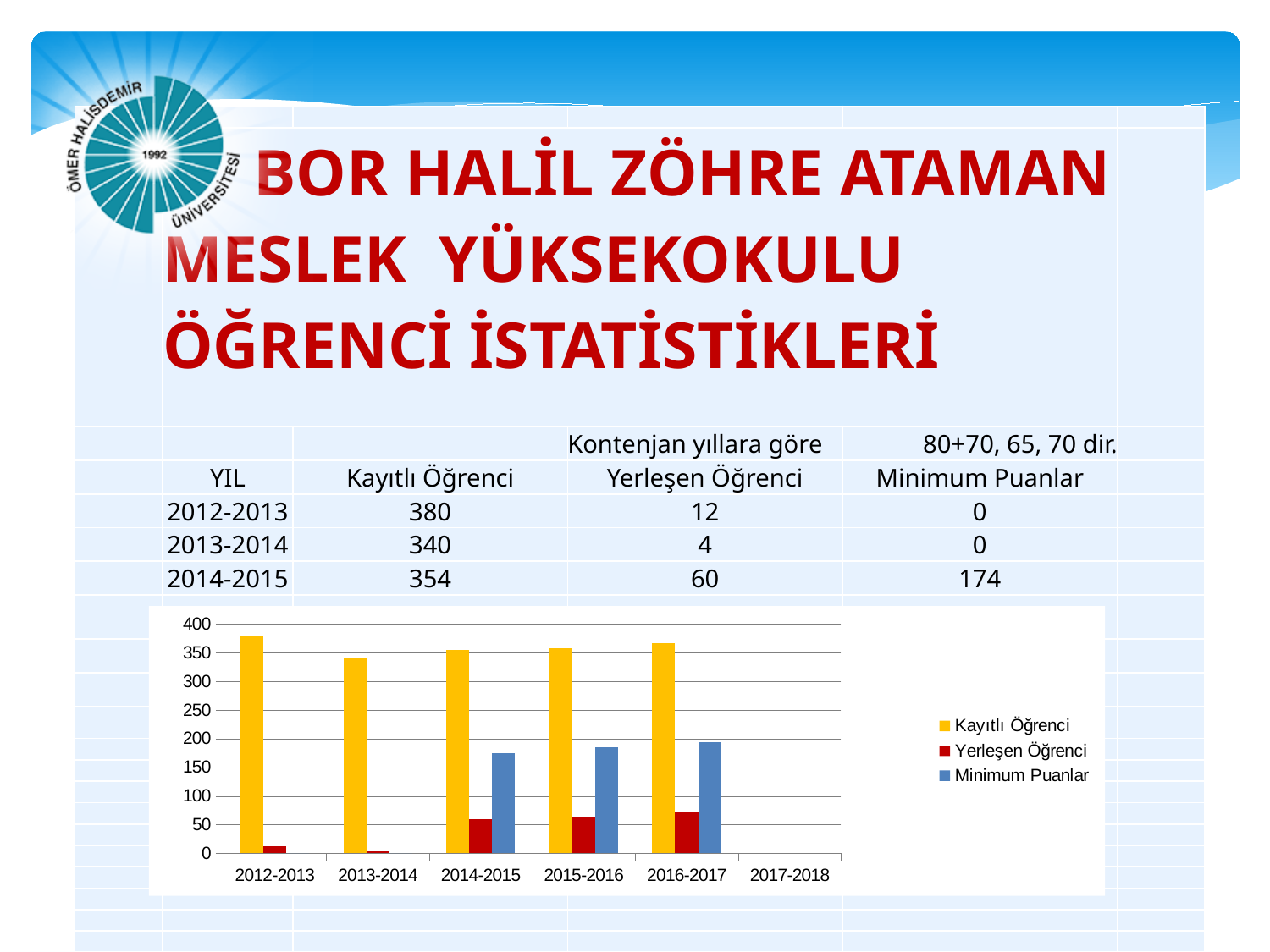
Which colour represents Kayıtlı Öğrenci in the chart legend? yellow How many series does the chart legend list? 3 Which year has the highest Kayıtlı Öğrenci bar? 2012-2013 What kind of chart is shown on the slide? bar chart How many categories are shown on the x axis of the chart? 6 What is the difference between the Kayıtlı Öğrenci values for 2012-2013 and 2013-2014? 40 Is the Yerleşen Öğrenci value for 2016-2017 greater or less than 100? less Which year has the lowest Yerleşen Öğrenci bar? 2013-2014 Is the Minimum Puanlar value for 2015-2016 greater or less than 150? greater What is the Kayıtlı Öğrenci value for 2012-2013? 380 What is the Minimum Puanlar value for 2014-2015? 174 What is the Yerleşen Öğrenci value for 2013-2014? 4